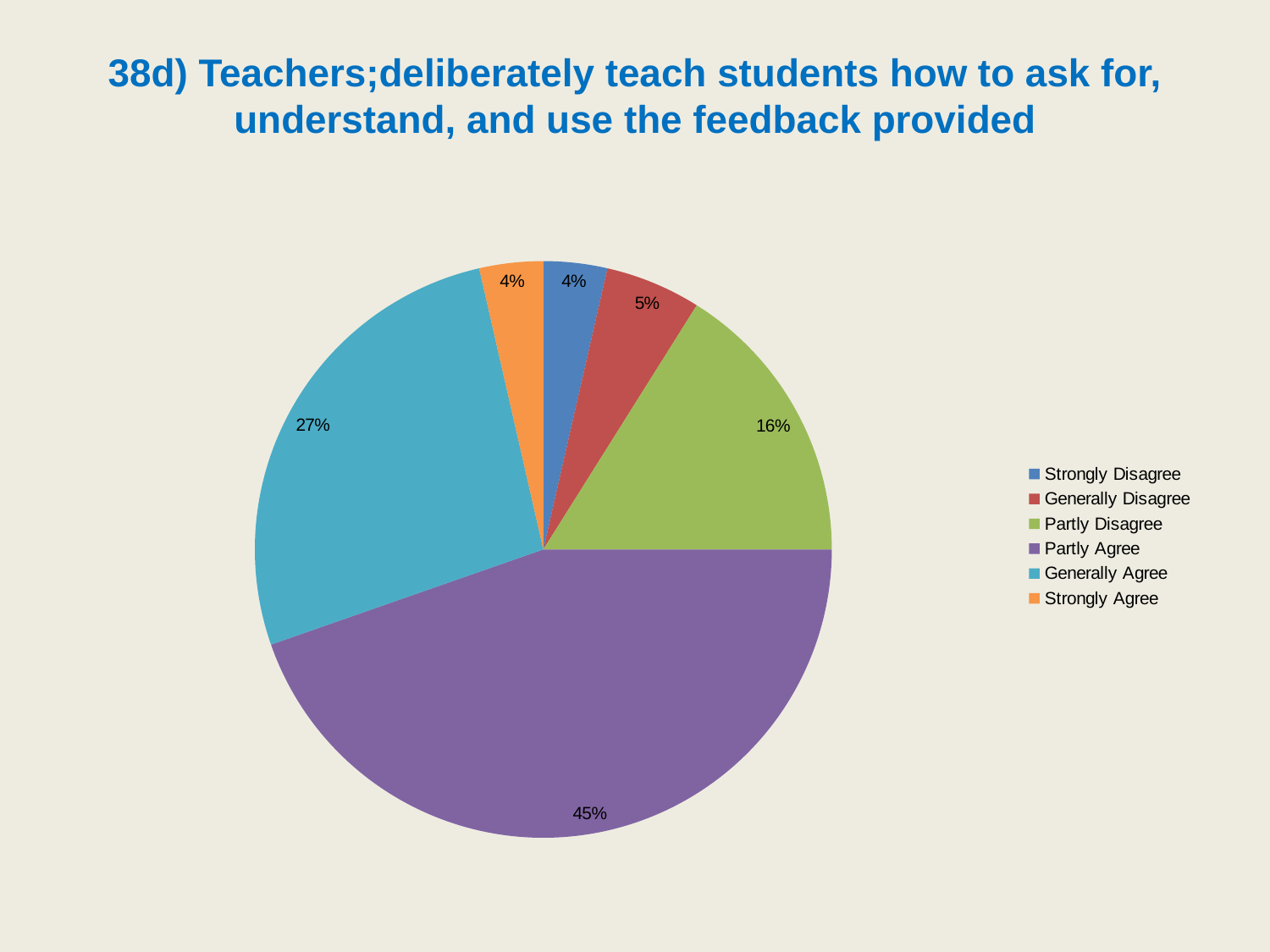
What share of the pie is Partly Agree? 45% Which is larger, the Partly Disagree slice or the Generally Disagree slice? Partly Disagree What share of the pie is Generally Agree? 27% What is the difference between the Partly Agree and Generally Agree shares? 18% Which category has the largest slice of the pie? Partly Agree Which colour represents Partly Agree in the legend? purple What is the combined share of Generally Agree and Strongly Agree? 31% What share of the pie is Strongly Agree? 4% How many categories does the pie chart have? 6 What kind of chart is shown on the slide? pie chart